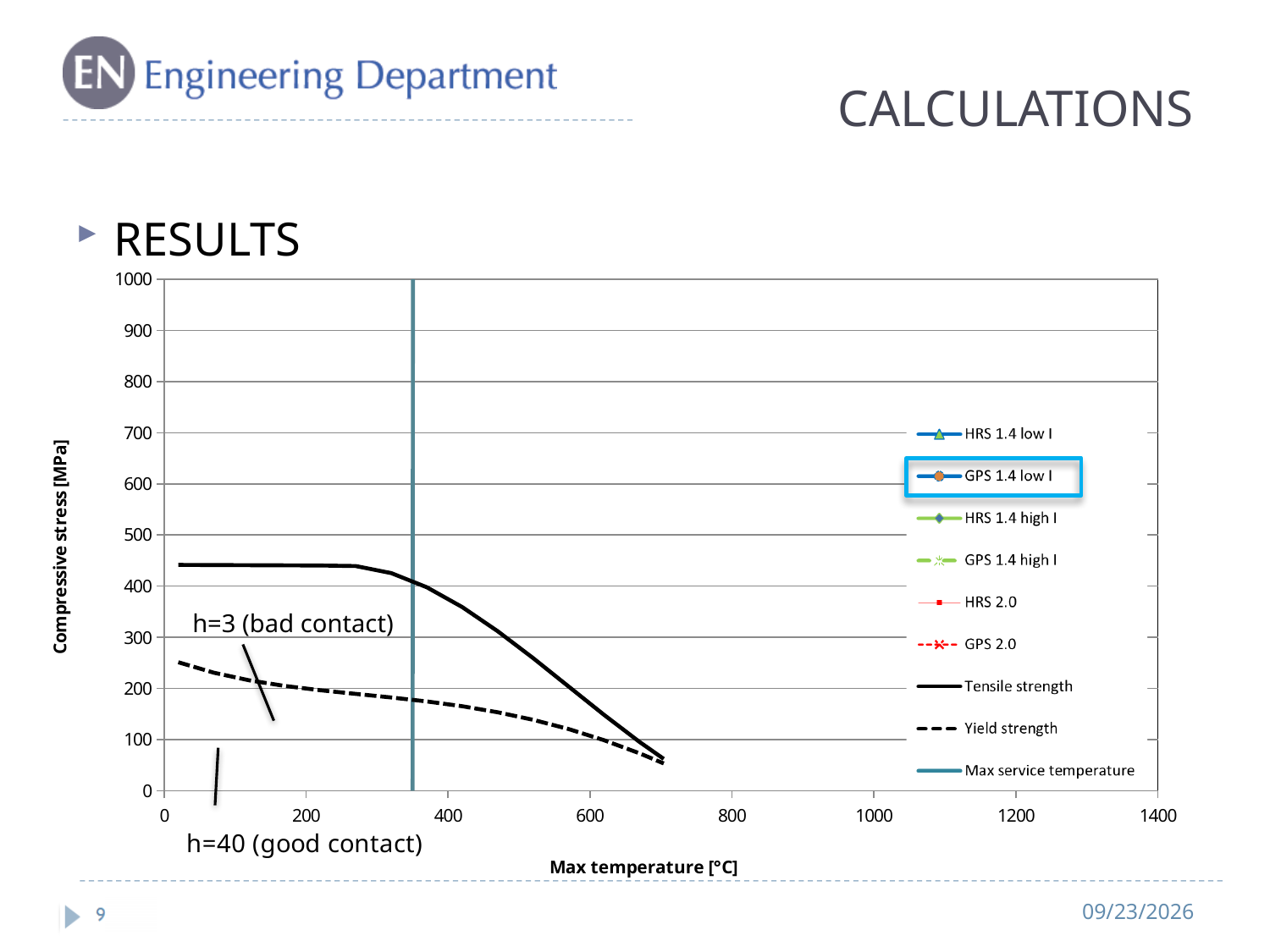
Is the Tensile strength value at 600 °C greater or less than 300? less Does the Tensile strength curve rise or fall as the max temperature increases beyond 300 °C? fall What is the highest value shown on the y axis? 1000 Is the Max service temperature line positioned at a temperature greater or less than 400 °C? less How many series does the chart legend list? 9 What kind of chart is shown on the slide? line chart Is the Yield strength value at 200 °C greater or less than 300? less Which legend entry is highlighted with a blue box? GPS 1.4 low I At 400 °C, which is larger: Tensile strength or Yield strength? Tensile strength What is the label of the x axis? Max temperature [°C]